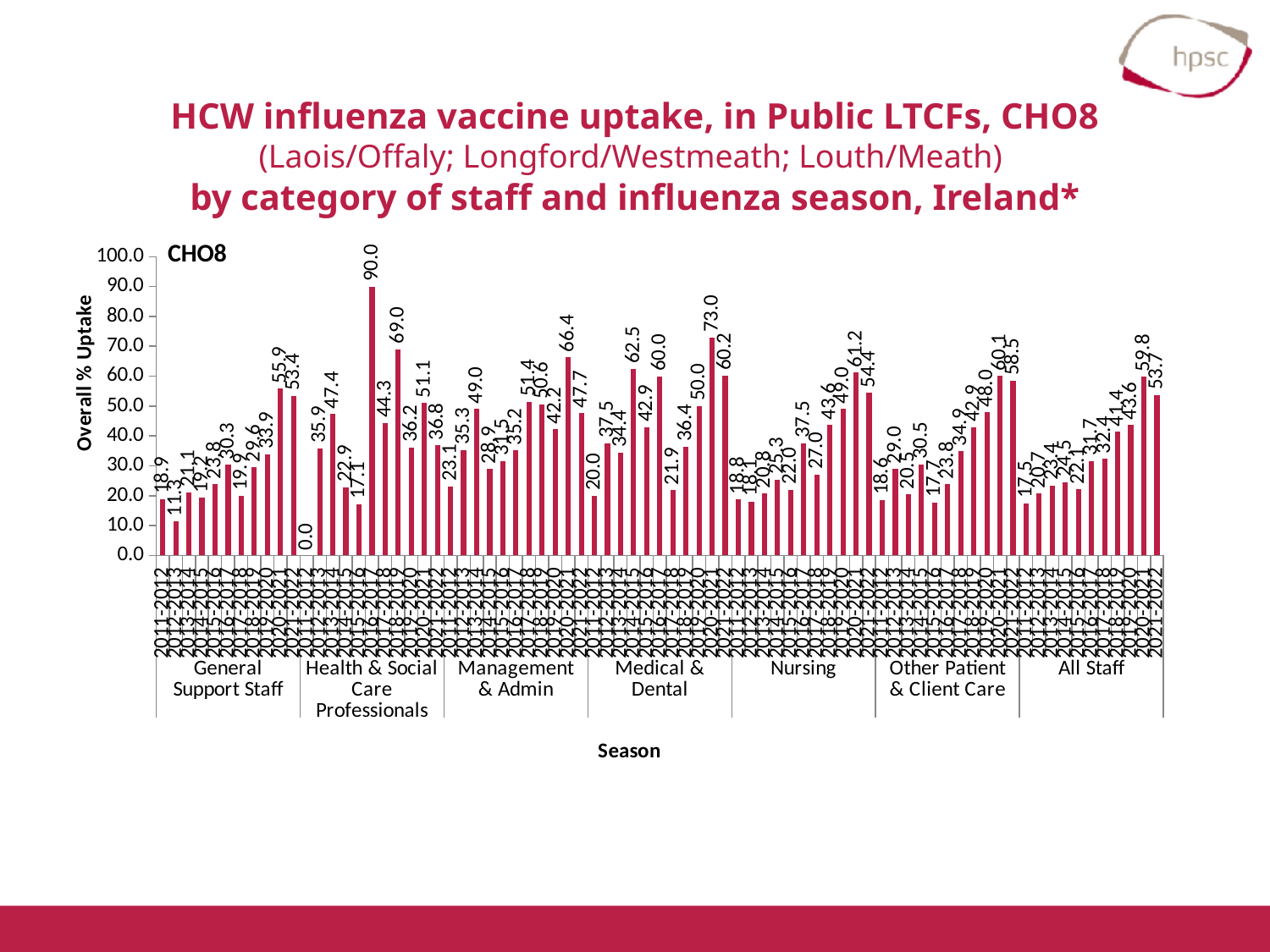
What is the difference between the highest value in the Medical & Dental group and the highest value in the Nursing group? 11.8 How many staff categories are shown along the x axis of the chart? 7 What is the difference between the two highest values in the Health & Social Care Professionals group (90.0 and 69.0)? 21.0 What is the highest value shown anywhere on the chart, and in which staff category does it occur? 90.0, Health & Social Care Professionals What is the lowest value shown on the chart, and in which staff category does it occur? 0.0, Health & Social Care Professionals Which is larger: the highest value in the All Staff group or the highest value in the General Support Staff group? All Staff (59.8) What is the label on the vertical axis of the chart? Overall % Uptake What is the highest value in the Medical & Dental group? 73.0 What is the label on the horizontal axis of the chart? Season What kind of chart is shown on the slide? Bar chart What is the highest value in the Nursing group? 61.2